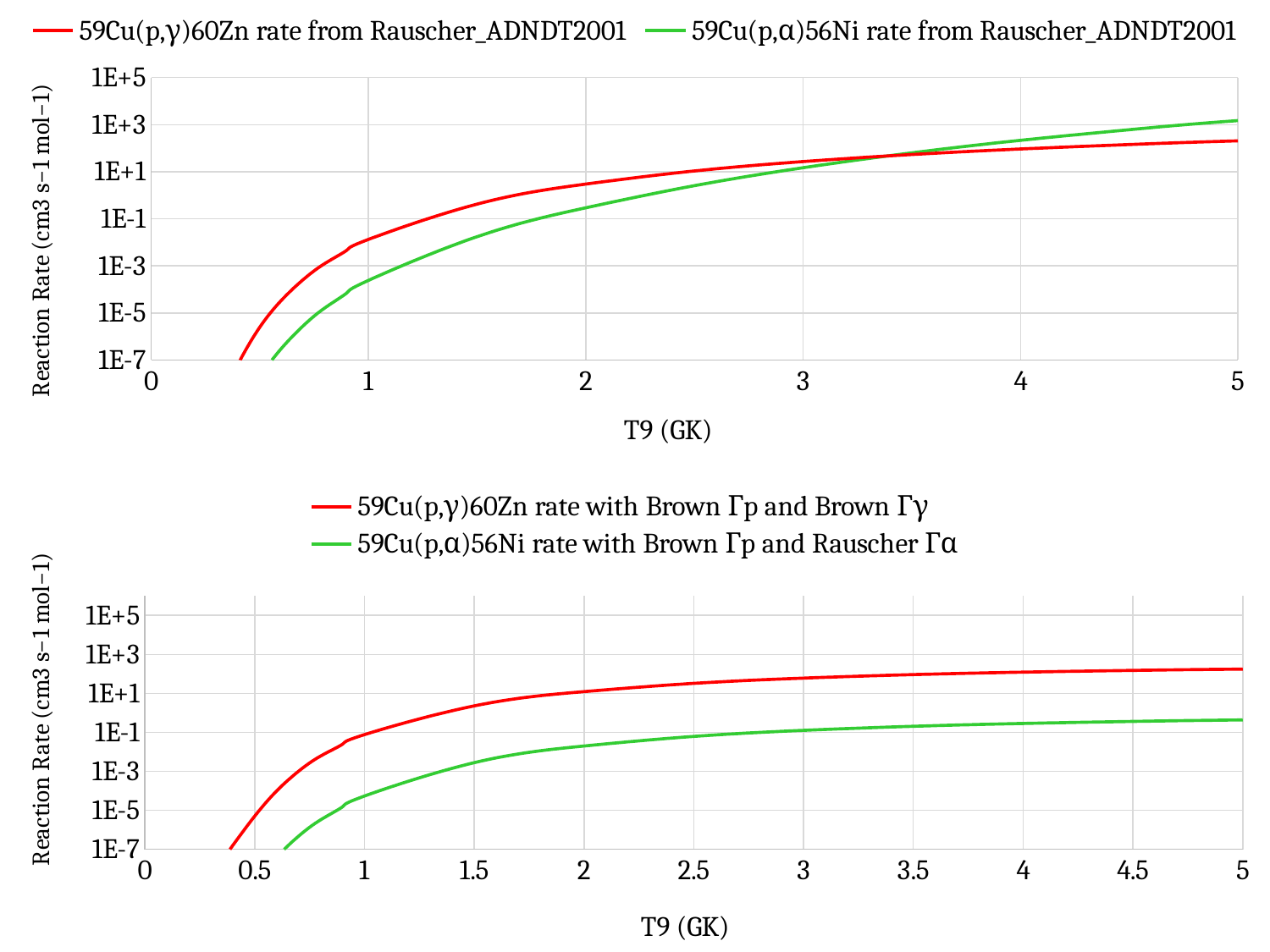
In the bottom chart, what colour is the line for the 59Cu(p,α)56Ni rate with Brown Γp and Rauscher Γα? green In the bottom chart, does the 59Cu(p,α)56Ni rate with Brown Γp and Rauscher Γα rise or fall as T9 increases? rise In the top chart, does the 59Cu(p,γ)60Zn rate from Rauscher_ADNDT2001 rise or fall as T9 increases? rise How many series does the legend of the top chart list? 2 How many series does the legend of the bottom chart list? 2 What kind of chart is the top chart on the slide? line chart In the bottom chart, is the 59Cu(p,γ)60Zn rate with Brown Γp and Brown Γγ at T9 = 5 GK greater or less than 1E+3? less In the top chart, at T9 = 1 GK, which series has the larger reaction rate? 59Cu(p,γ)60Zn rate from Rauscher_ADNDT2001 In the top chart, at T9 = 5 GK, which series has the larger reaction rate? 59Cu(p,α)56Ni rate from Rauscher_ADNDT2001 What is the x-axis label of the top chart? T9 (GK) In the bottom chart, is the 59Cu(p,α)56Ni rate with Brown Γp and Rauscher Γα at T9 = 5 GK greater or less than 1E+1? less In the bottom chart, at T9 = 3 GK, which series has the larger reaction rate? 59Cu(p,γ)60Zn rate with Brown Γp and Brown Γγ